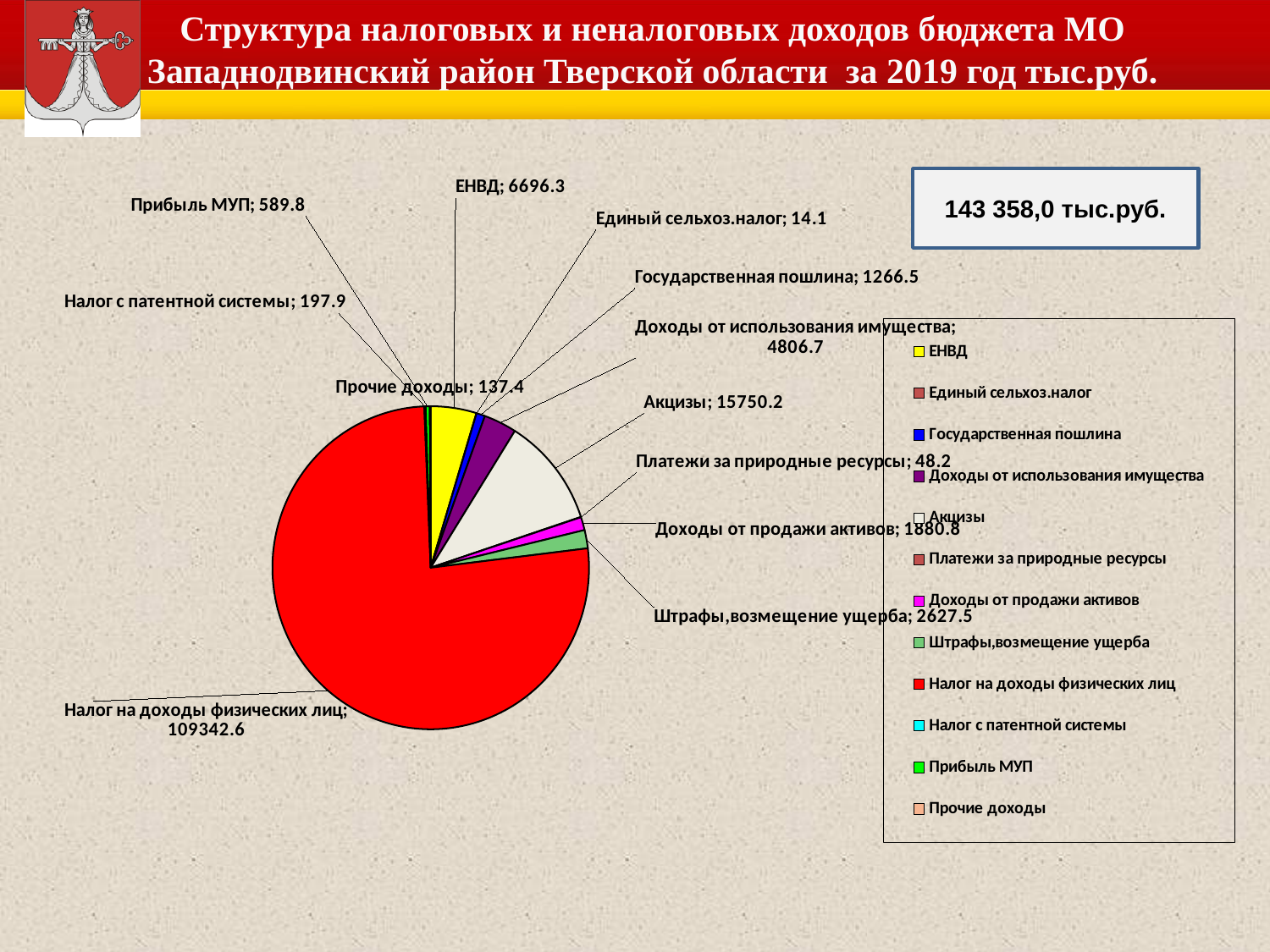
What is the difference between Акцизы and ЕНВД? 9053.9 Which is larger, Прибыль МУП or Налог с патентной системы? Прибыль МУП What is the value for Единый сельхоз.налог? 14.1 What total amount is shown in the box at the top right of the slide? 143 358,0 тыс.руб. What is the value for Акцизы? 15750.2 How many categories does the legend list? 12 What is the value for Налог на доходы физических лиц? 109342.6 What type of chart is shown on the slide? pie chart Which category has the largest slice of the pie? Налог на доходы физических лиц Which category has the smallest value? Единый сельхоз.налог What is the value for Доходы от использования имущества? 4806.7 What is the difference between Штрафы,возмещение ущерба and Доходы от продажи активов? 746.7